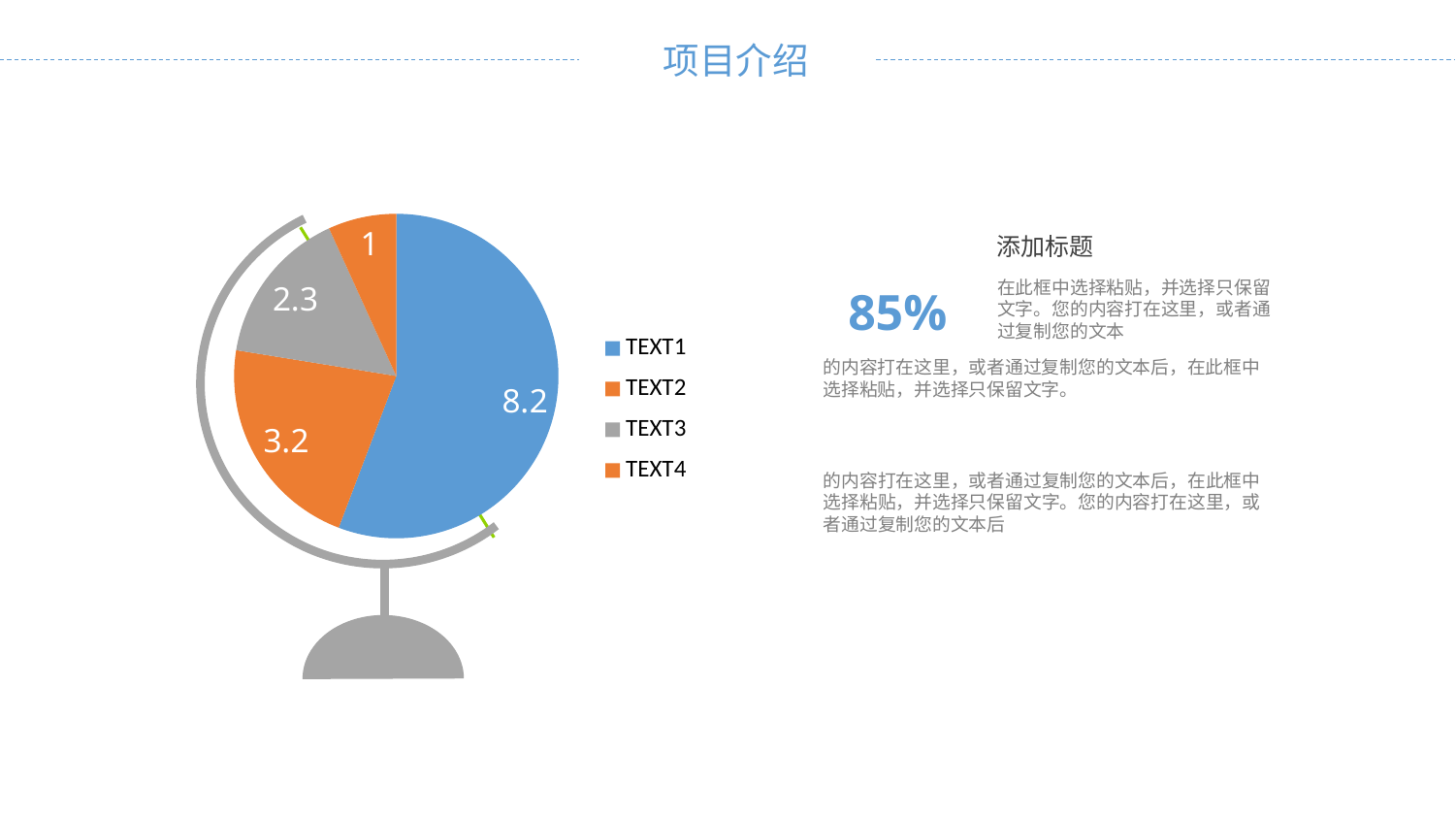
What colour is the TEXT3 slice in the pie chart? gray What is the value of the TEXT2 slice in the pie chart? 3.2 How many entries does the pie chart's legend list? 4 How many slices does the pie chart have? 4 What is the value of the TEXT1 slice in the pie chart? 8.2 What type of chart is shown on the slide? pie chart Which category has the largest slice in the pie chart? TEXT1 What is the difference between the TEXT1 and TEXT2 values in the pie chart? 5 Which category has the smallest slice in the pie chart? TEXT4 Which is larger in the pie chart, TEXT2 or TEXT3? TEXT2 What is the value of the TEXT3 slice in the pie chart? 2.3 What is the value of the TEXT4 slice in the pie chart? 1